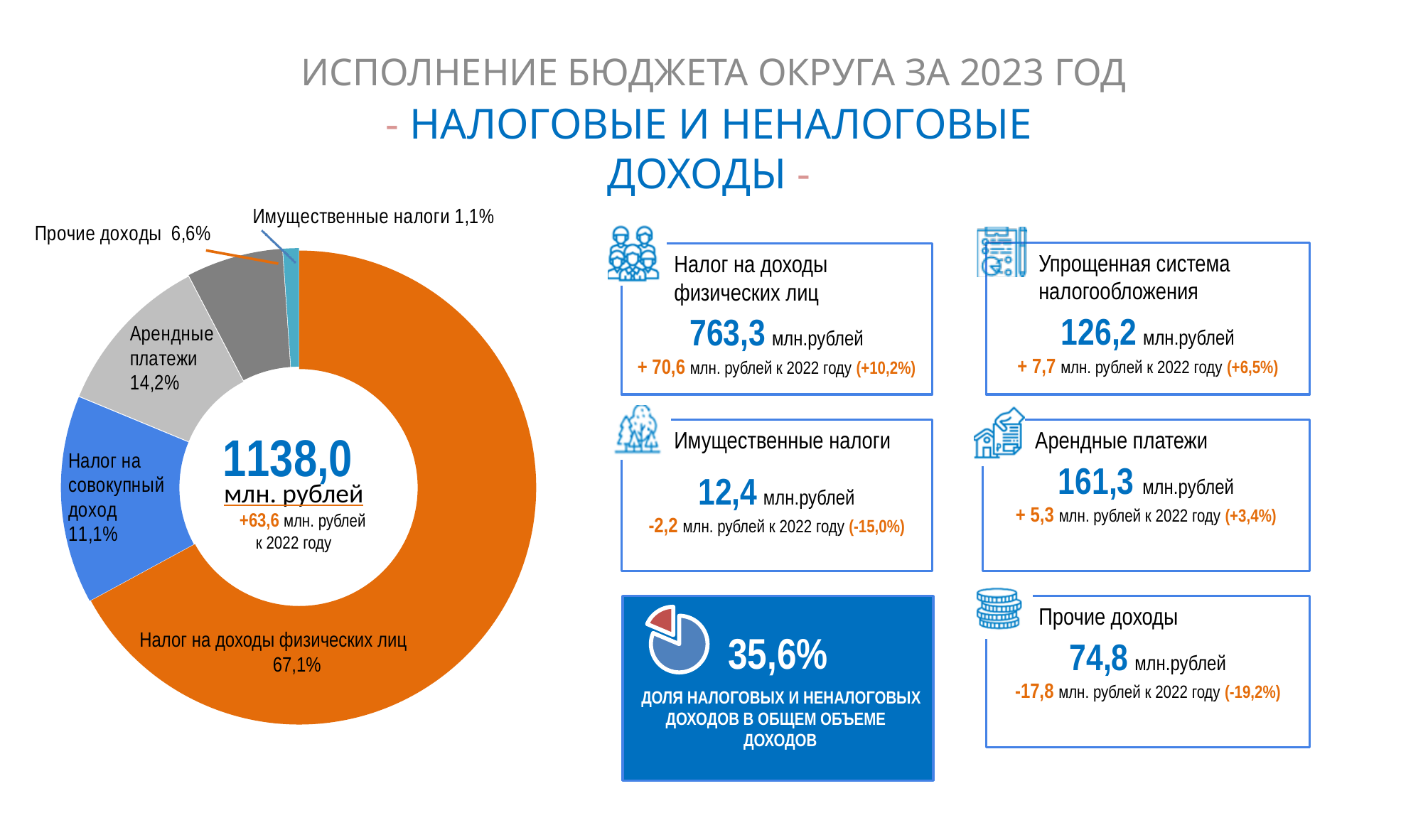
What share of the donut chart is labelled for Налог на доходы физических лиц? 67,1% Which category has the largest slice in the donut chart? Налог на доходы физических лиц What is the difference in percentage points between the Арендные платежи slice and the Прочие доходы slice in the donut chart? 7,6 Which category has the smallest slice in the donut chart? Имущественные налоги What kind of chart is shown on the slide? Pie (donut) chart What share of the donut chart is labelled for Прочие доходы? 6,6% How many slices does the donut chart have? 5 What total value is printed in the centre of the donut chart? 1138,0 млн. рублей What share of the donut chart is labelled for Имущественные налоги? 1,1% In the donut chart, which slice is larger: Арендные платежи or Налог на совокупный доход? Арендные платежи